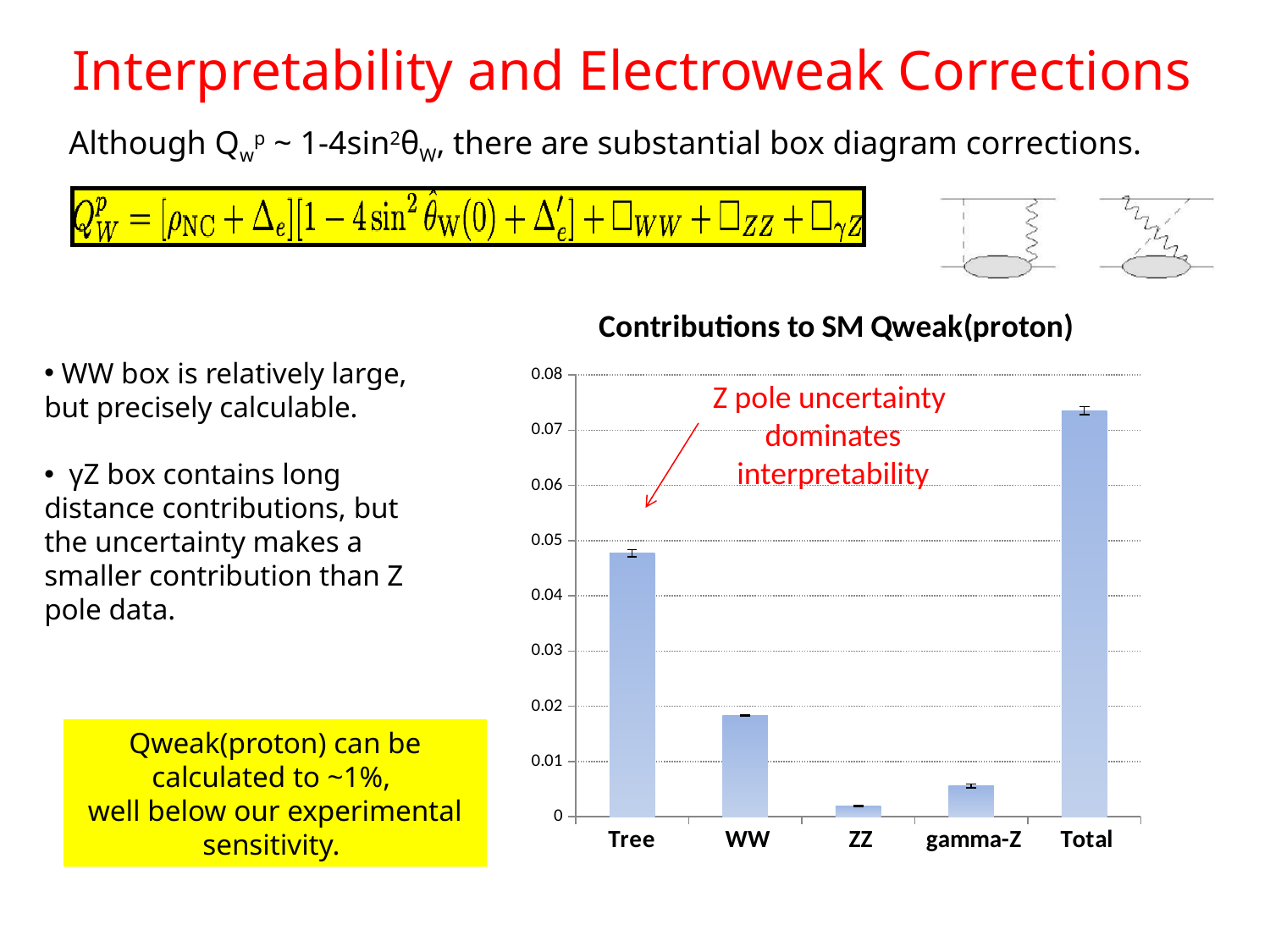
Is the value for WW greater or less than 0.02? less Which is larger, the value for gamma-Z or the value for ZZ? gamma-Z Is the value for Total greater or less than 0.07? greater How many categories are plotted on the x axis of the chart? 5 Is the value for Tree greater or less than 0.04? greater What is the title of the chart? Contributions to SM Qweak(proton) What kind of chart is shown on the slide? bar chart Which is larger, the value for Tree or the value for WW? Tree Which category has the lowest bar in the chart? ZZ Which category does the red annotation 'Z pole uncertainty dominates interpretability' point to? Tree Which category has the highest bar in the chart? Total